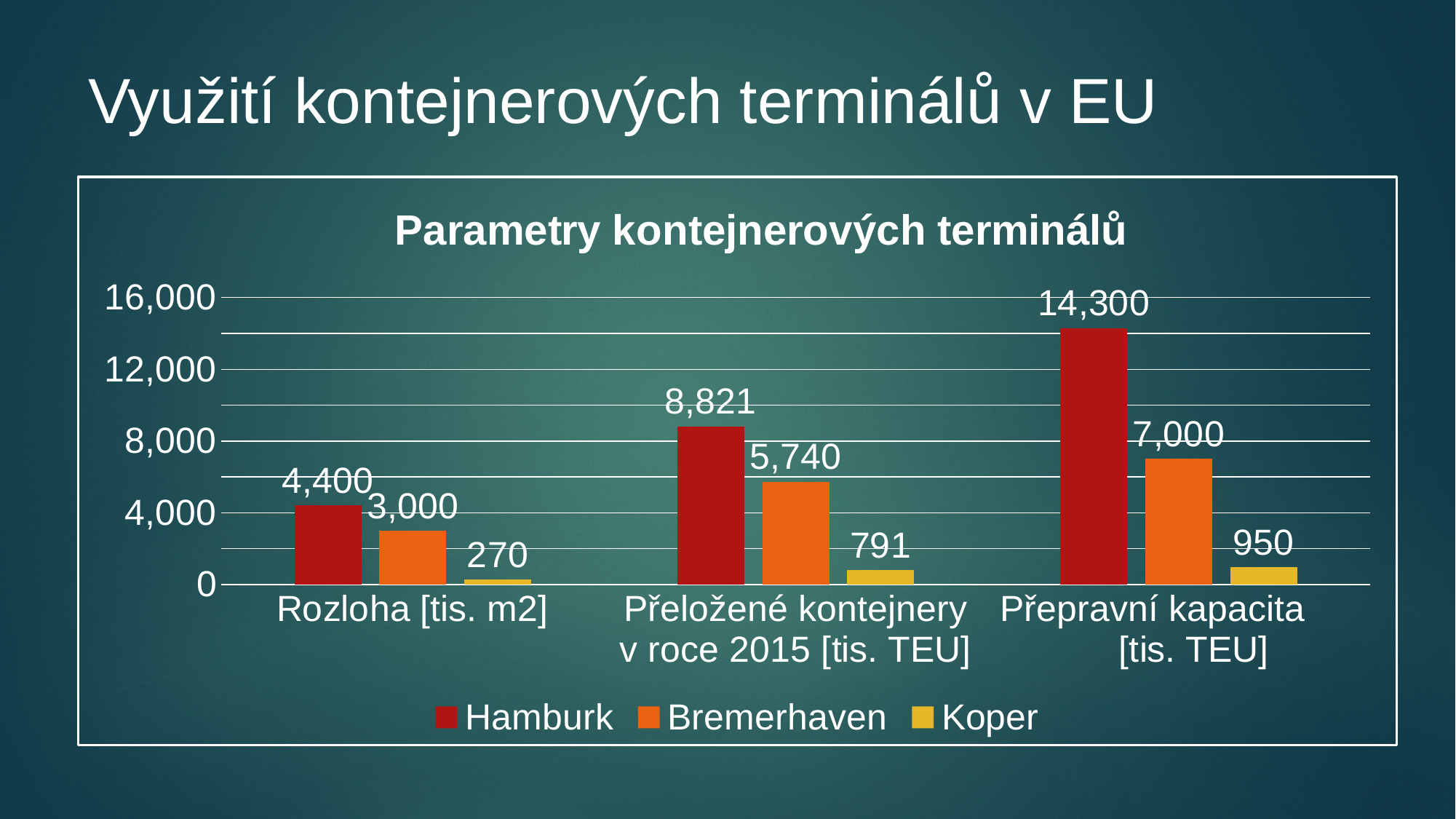
What is the difference between Hamburk and Koper in the Přepravní kapacita [tis. TEU] category? 13,350 What is the difference between Hamburk and Bremerhaven in the Přeložené kontejnery v roce 2015 [tis. TEU] category? 3,081 What is the value for Koper in the Přeložené kontejnery v roce 2015 [tis. TEU] category? 791 Which series has the lowest value in the Rozloha [tis. m2] category? Koper How many series does the legend list? 3 Which series has the highest value in the Přepravní kapacita [tis. TEU] category? Hamburk What is the value for Hamburk in the Rozloha [tis. m2] category? 4,400 What kind of chart is shown on the slide? Bar chart Which is larger: Bremerhaven's Rozloha [tis. m2] value or Koper's Přepravní kapacita [tis. TEU] value? Bremerhaven's Rozloha [tis. m2] value How many categories are shown on the x axis? 3 What is the value for Bremerhaven in the Přepravní kapacita [tis. TEU] category? 7,000 What is the title of the chart? Parametry kontejnerových terminálů